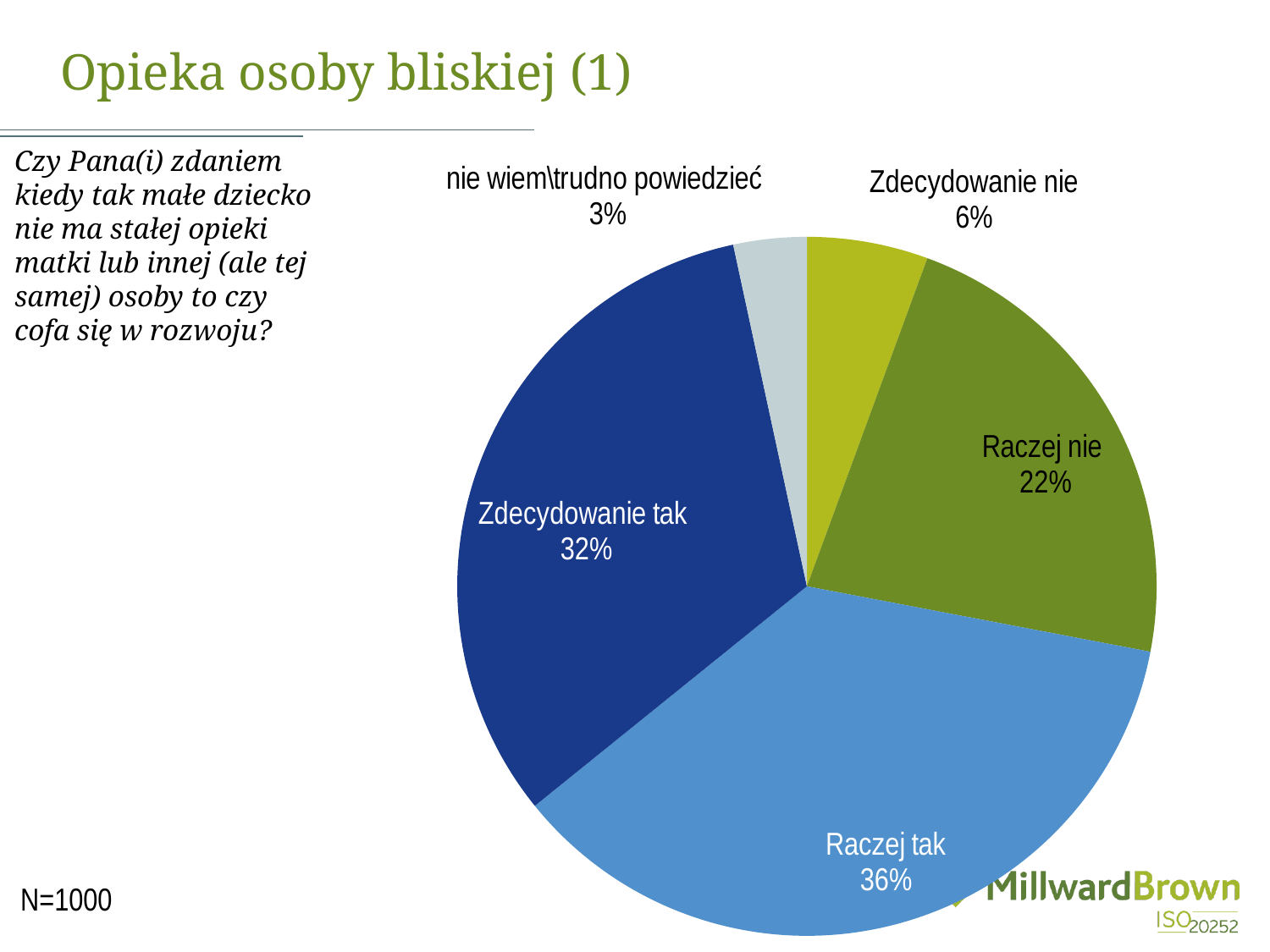
What percentage of respondents answered "nie wiem\trudno powiedzieć"? 3% What is the sample size (N) stated on the slide? N=1000 What percentage of respondents answered "Zdecydowanie nie"? 6% How many slices does the pie chart have? 5 What percentage of respondents answered "Raczej tak"? 36% What percentage of respondents answered "Raczej nie"? 22% What percentage of respondents answered "Zdecydowanie tak"? 32% What is the difference in percentage points between "Raczej tak" and "Zdecydowanie tak"? 4 What kind of chart is shown on the slide? pie chart Which response has the largest share of the pie? Raczej tak Which response has the smallest share of the pie? nie wiem\trudno powiedzieć Which is larger, the share for "Raczej nie" or the share for "Zdecydowanie nie"? Raczej nie